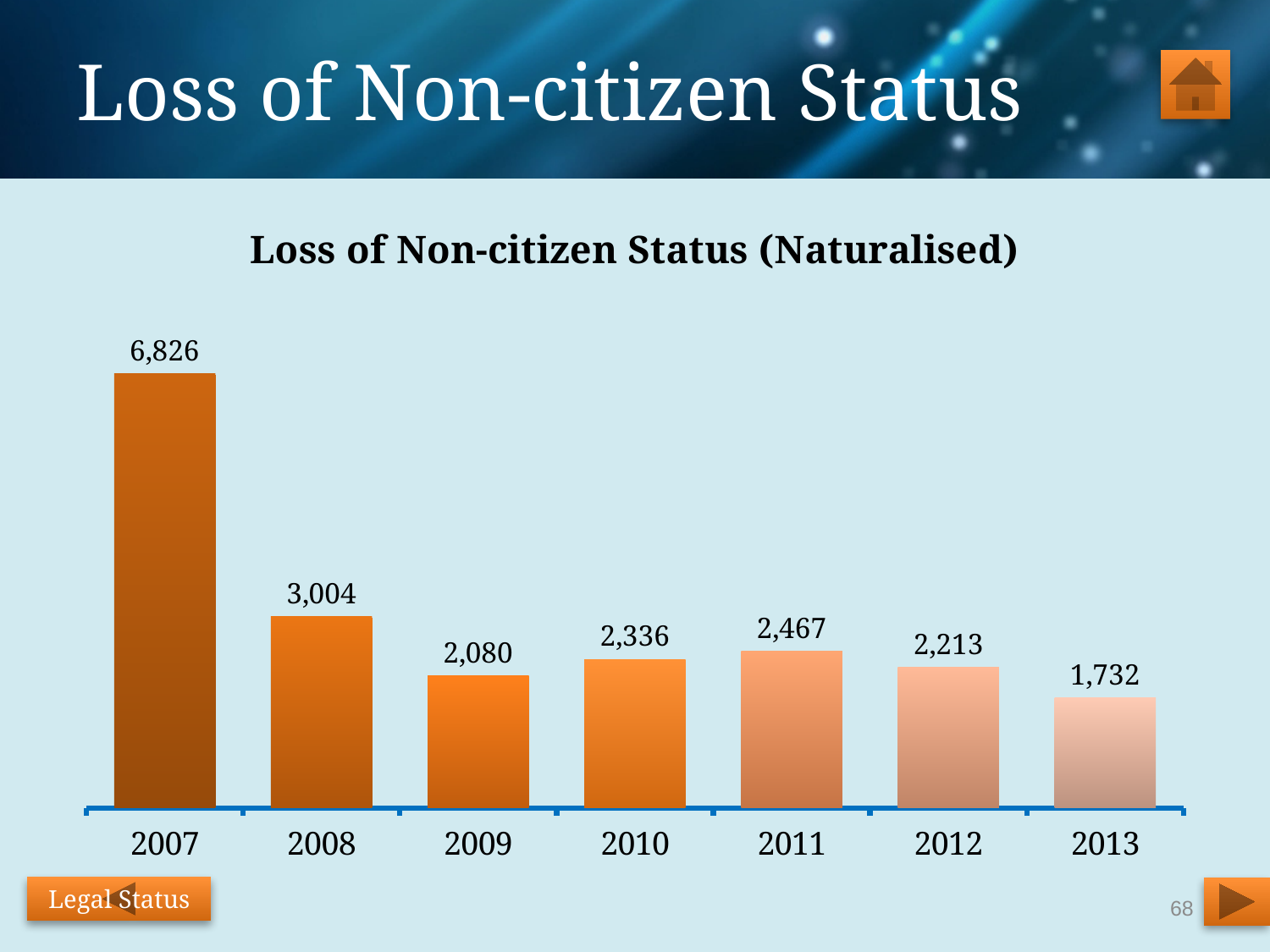
What is the difference between the values for 2011 and 2012? 254 What is the value for 2010? 2,336 Which year has the lowest value? 2013 What is the value for 2007? 6,826 What is the value for 2013? 1,732 Do the values rise or fall from 2010 to 2011? rise Which is larger, the value for 2009 or the value for 2011? 2011 Which year has the highest value? 2007 What is the title of the chart? Loss of Non-citizen Status (Naturalised) What is the difference between the values for 2007 and 2008? 3,822 How many years are shown on the x axis? 7 What kind of chart is shown? bar chart